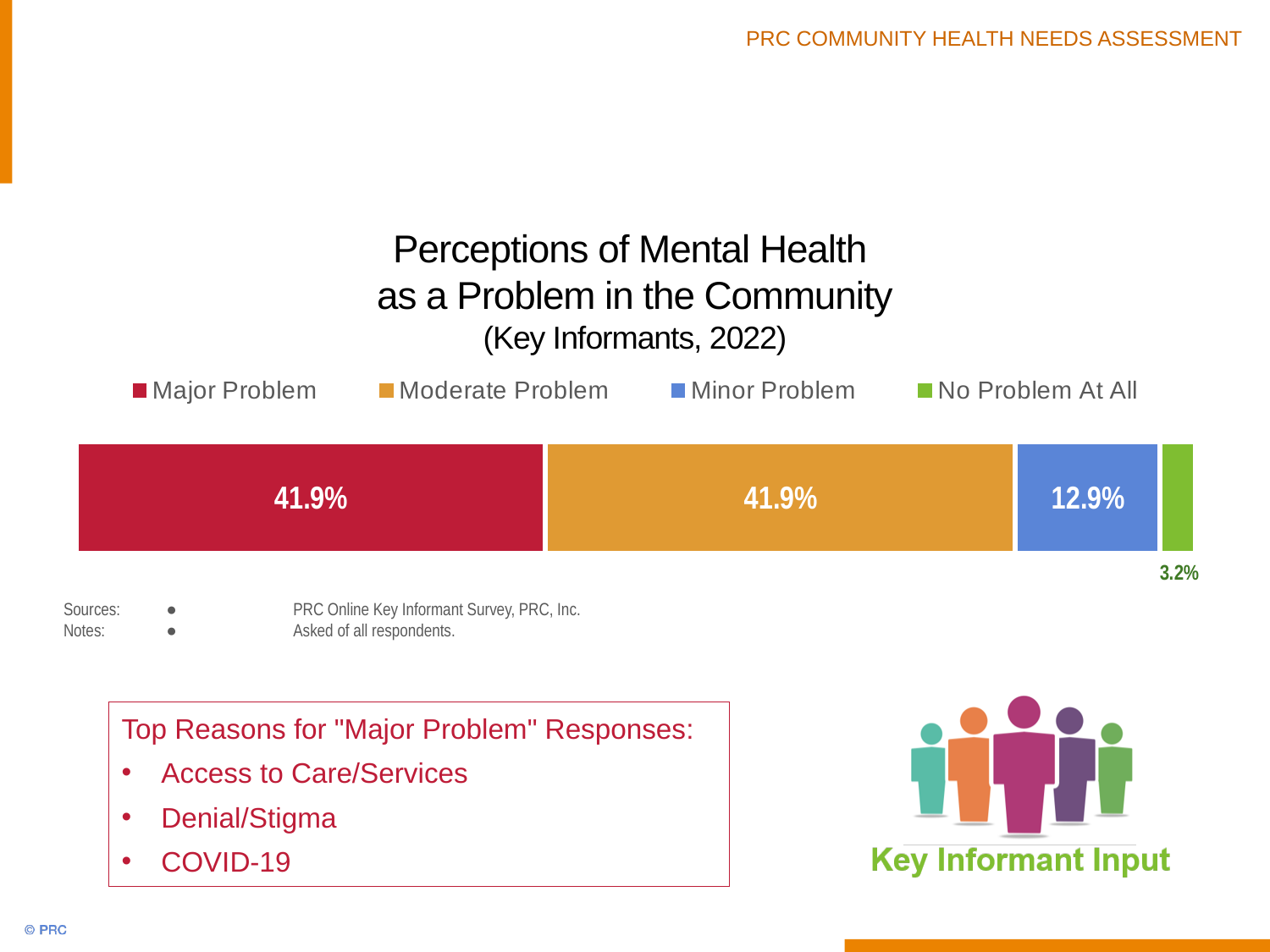
What colour represents the Moderate Problem segment in the chart? Orange How many series does the legend list? 4 What kind of chart is shown on the slide? Stacked bar chart Which response category has the smallest share in the chart? No Problem At All What is the difference between the Minor Problem share and the No Problem At All share? 9.7% What percentage of key informants rated mental health a Moderate Problem? 41.9% What is the difference between the Major Problem share and the Minor Problem share? 29.0% What percentage of key informants rated mental health a Minor Problem? 12.9% What percentage of key informants rated mental health a Major Problem? 41.9% Which is larger, the share for Minor Problem or the share for No Problem At All? Minor Problem What percentage of key informants said mental health is No Problem At All? 3.2% What is the total of all four segments in the stacked bar? 99.9%